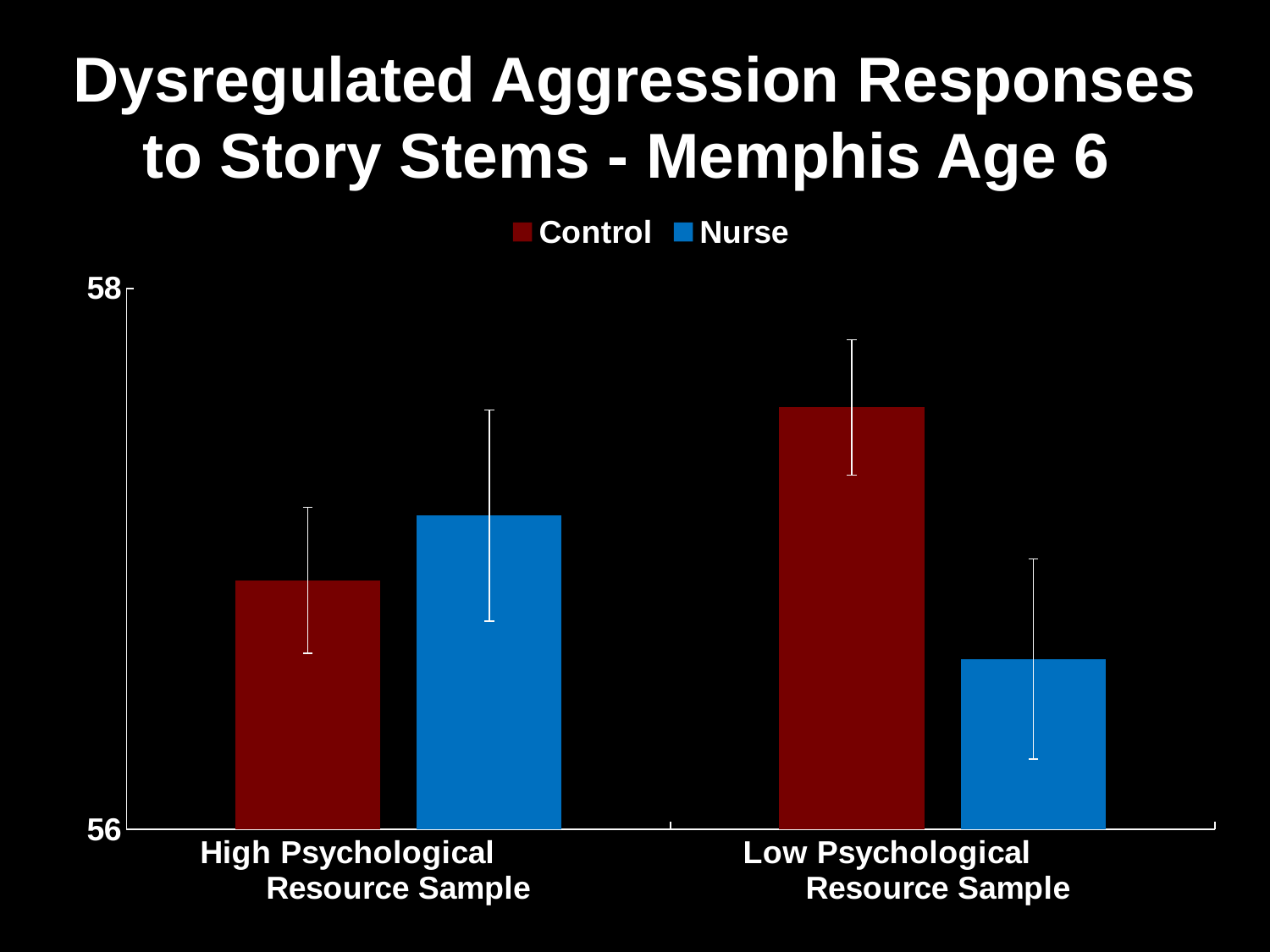
In the Low Psychological Resource Sample, which is larger, Control or Nurse? Control How many series does the legend list? 2 Which bar is the tallest in the chart? Control, Low Psychological Resource Sample Which bar is the shortest in the chart? Nurse, Low Psychological Resource Sample Which series is shown in blue? Nurse In the High Psychological Resource Sample, which is larger, Control or Nurse? Nurse How many categories are shown on the x axis? 2 What is the title of the chart? Dysregulated Aggression Responses to Story Stems - Memphis Age 6 What kind of chart is shown on the slide? bar chart Is the Control value for the Low Psychological Resource Sample greater or less than 58? less Which sample has the higher Control value, High Psychological Resource Sample or Low Psychological Resource Sample? Low Psychological Resource Sample